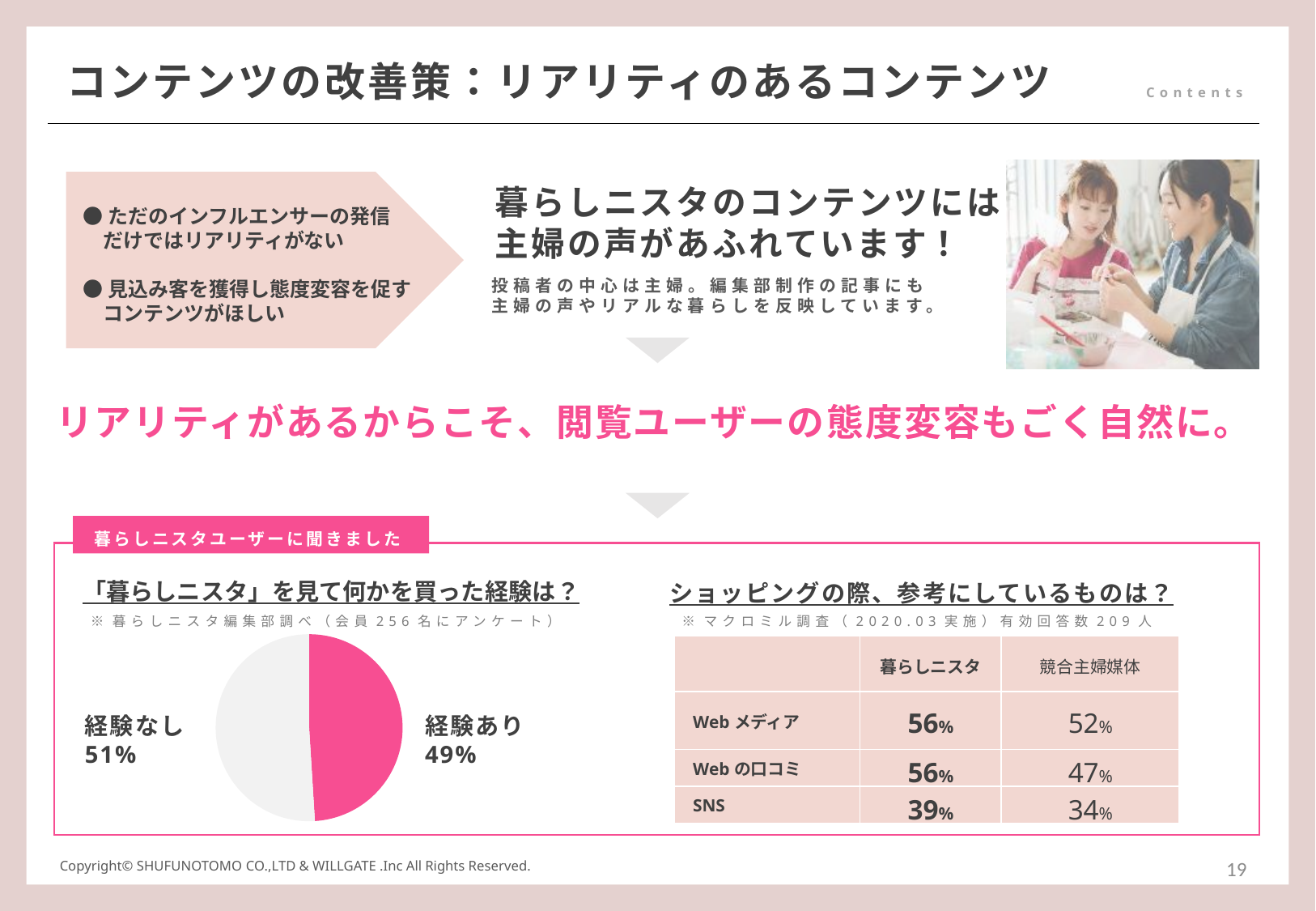
In the pie chart, what is the value for 経験なし? 51% In the pie chart, which is larger, 経験あり or 経験なし? 経験なし How many slices does the pie chart have? 2 Which slice of the pie chart is the largest? 経験なし What share of the pie does the 経験あり slice represent? 49% In the pie chart, what is the difference between 経験なし and 経験あり? 2% Which slice of the pie chart is the smallest? 経験あり What kind of chart is shown under the heading 「暮らしニスタ」を見て何かを買った経験は？? pie chart Is the value for 経験なし in the pie chart greater or less than 50%? greater According to the note under the pie chart title, how many members were surveyed? 256名 In the pie chart, what is the value for 経験あり? 49% What colour is the 経験あり slice in the pie chart? pink